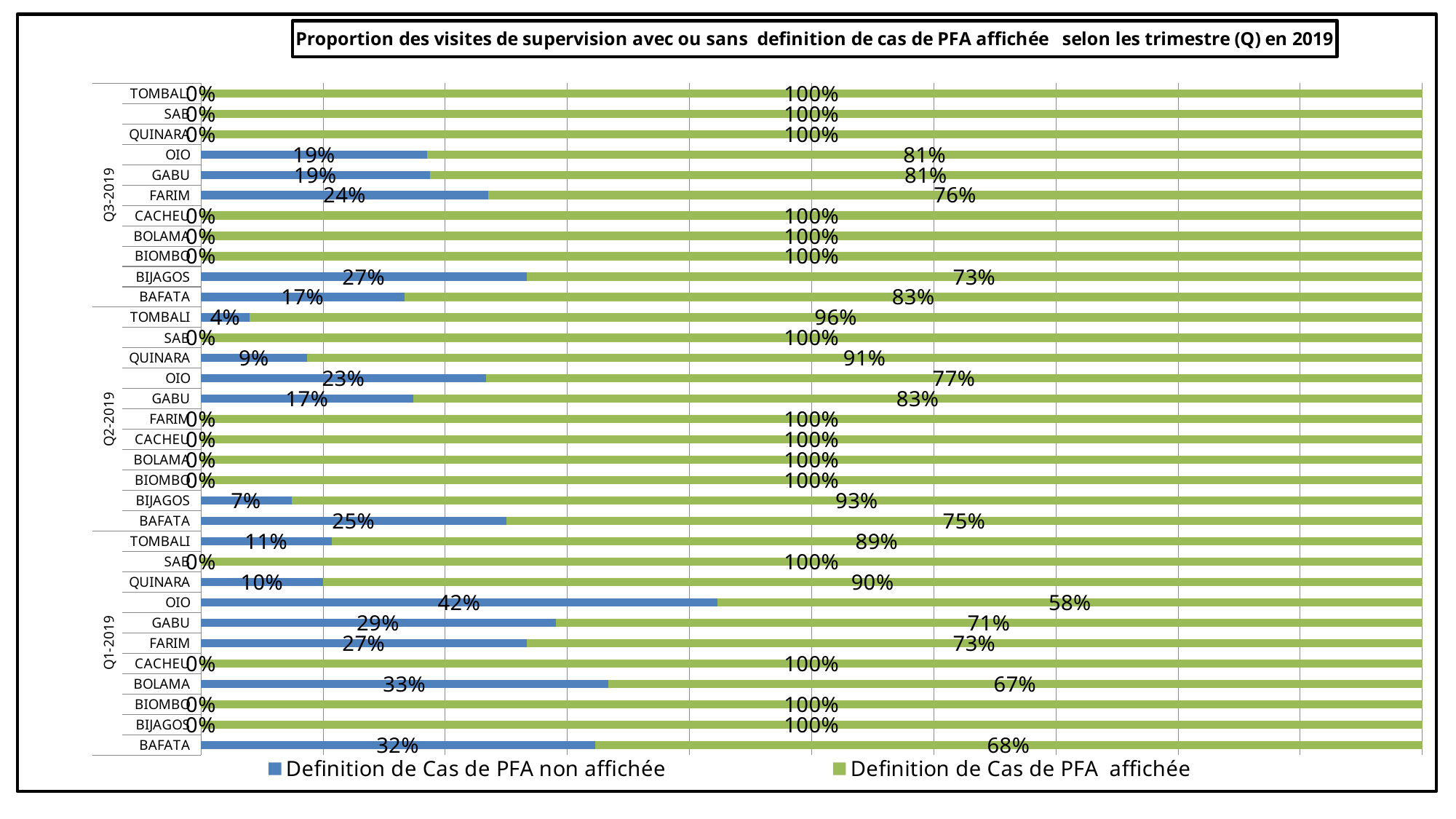
What is the value of 'Definition de Cas de PFA affichée' for TOMBALI in Q2-2019? 96% What is the value of 'Definition de Cas de PFA non affichée' for OIO in Q1-2019? 42% What is the value of 'Definition de Cas de PFA affichée' for BOLAMA in Q1-2019? 67% Which region in Q1-2019 has the highest value for 'Definition de Cas de PFA non affichée'? OIO What is the total of the stacked bar for GABU in Q2-2019? 100% Which is larger: the 'Definition de Cas de PFA non affichée' value for BAFATA in Q1-2019 or for BAFATA in Q2-2019? BAFATA in Q1-2019 What is the title of the chart? Proportion des visites de supervision avec ou sans definition de cas de PFA affichée selon les trimestre (Q) en 2019 What kind of chart is shown on the slide? Bar chart How many bars (region-quarter combinations) are plotted in the chart? 33 What is the value of 'Definition de Cas de PFA non affichée' for BIJAGOS in Q3-2019? 27% How many series does the legend list? 2 What is the difference between the 'Definition de Cas de PFA affichée' values for OIO in Q1-2019 and OIO in Q3-2019? 23%